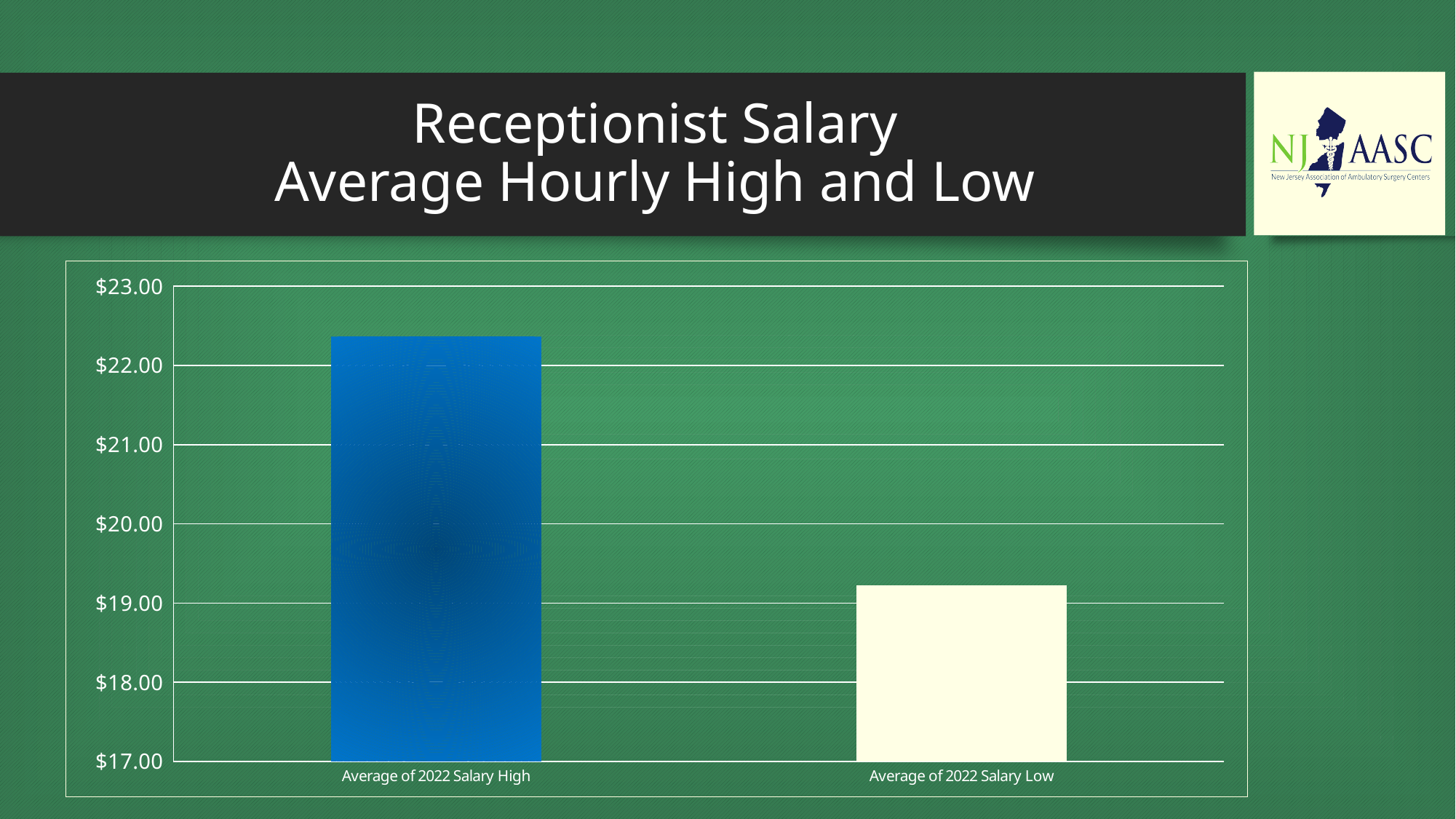
What is the lowest value shown on the vertical axis? $17.00 Is the value for Average of 2022 Salary High greater or less than $23.00? less How many bars are plotted in the chart? 2 Is the value for Average of 2022 Salary Low greater or less than $20.00? less Is the value for Average of 2022 Salary Low greater or less than $19.00? greater Which category has the highest value? Average of 2022 Salary High What is the title of the slide containing the chart? Receptionist Salary Average Hourly High and Low Which is larger, the value for Average of 2022 Salary High or Average of 2022 Salary Low? Average of 2022 Salary High What kind of chart is shown on the slide? bar chart Which category has the lowest value? Average of 2022 Salary Low